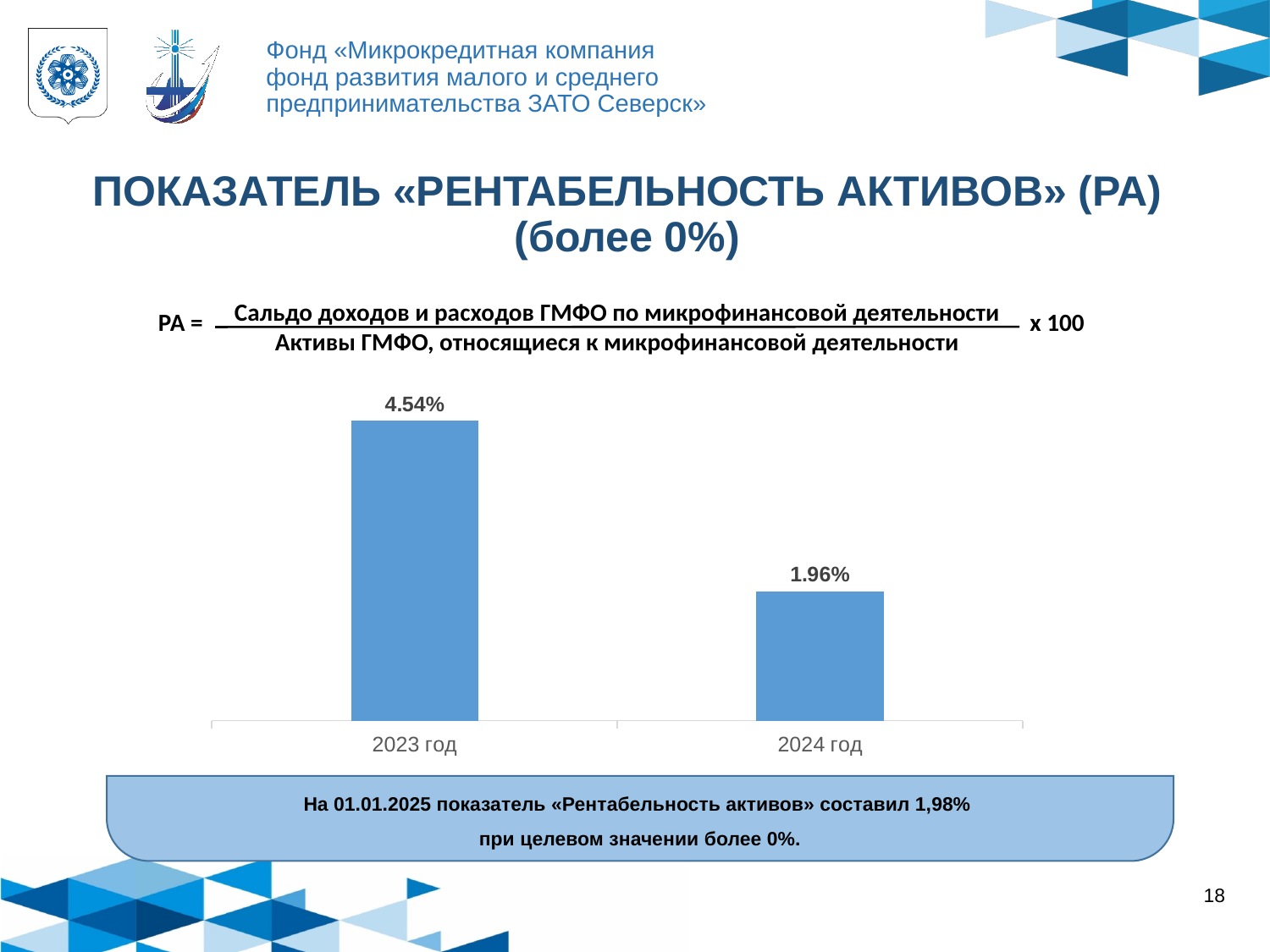
Which is larger, the value for 2023 год or for 2024 год? 2023 год What indicator does the slide title say the chart shows? Рентабельность активов (РА) Which year has the lowest value? 2024 год What is the value for 2023 год? 4.54% How many categories are shown on the x axis? 2 Which year has the highest value? 2023 год What colour are the bars in the chart? Blue What kind of chart is shown on the slide? Bar chart What is the value for 2024 год? 1.96% What is the difference between the values for 2023 год and 2024 год? 2.58% Do the values rise or fall from 2023 год to 2024 год? Fall